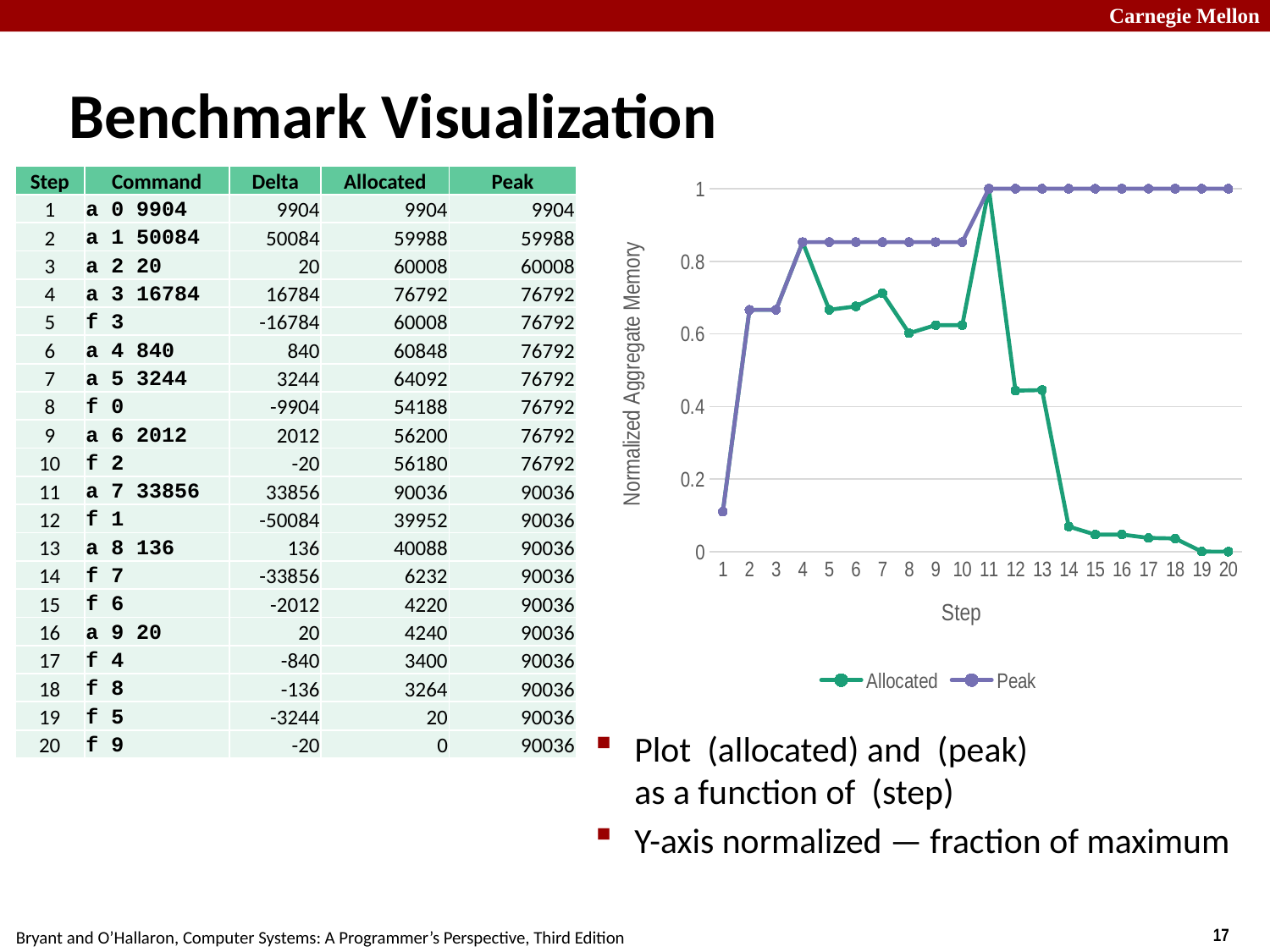
Does the Allocated series rise or fall from step 11 to step 20? fall How many steps are plotted along the x axis of the chart? 20 What is the value of the Allocated series at step 20? 0 What kind of chart is shown on the slide? line chart Is the value of the Allocated series at step 14 greater or less than 0.2? less What is the value of the Peak series at step 11? 1 What is the label of the chart's y axis? Normalized Aggregate Memory At step 12, which series has the larger value, Allocated or Peak? Peak Is the value of the Peak series at step 4 greater or less than 0.8? greater How many series does the chart's legend list? 2 What is the label of the chart's x axis? Step Is the value of the Allocated series at step 2 greater or less than 0.6? greater